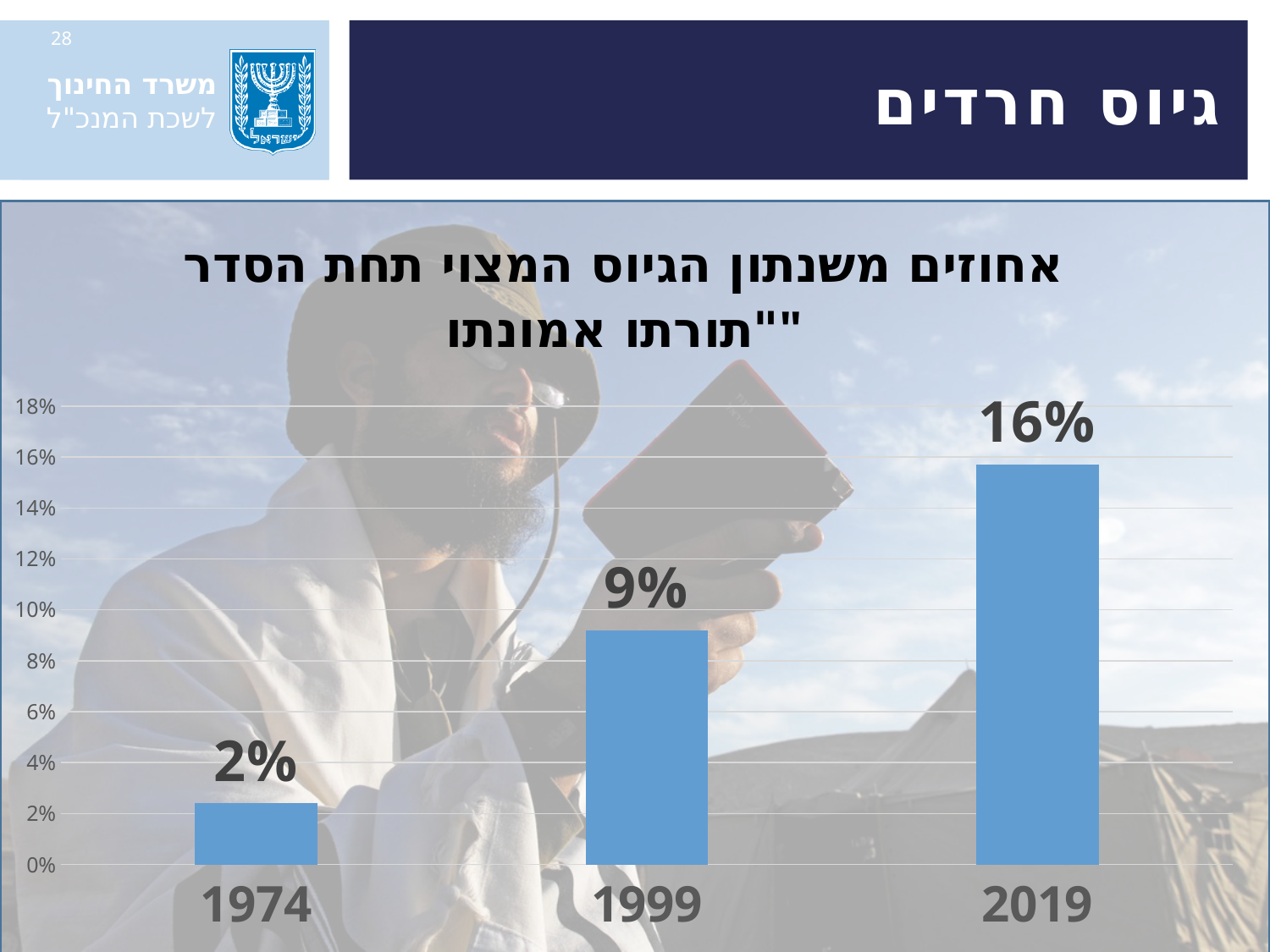
Is the value for 2019 greater or less than 14%? greater How many years are shown on the x axis? 3 What is the value for 1999? 9% What is the difference between the values for 2019 and 1999? 7% What kind of chart is shown on the slide? bar chart What is the value for 2019? 16% What is the difference between the values for 1999 and 1974? 7% Do the values rise or fall from 1974 to 2019? rise What is the value for 1974? 2% Which year has the highest value? 2019 Which year has the lowest value? 1974 Which is larger, the value for 1999 or the value for 1974? 1999